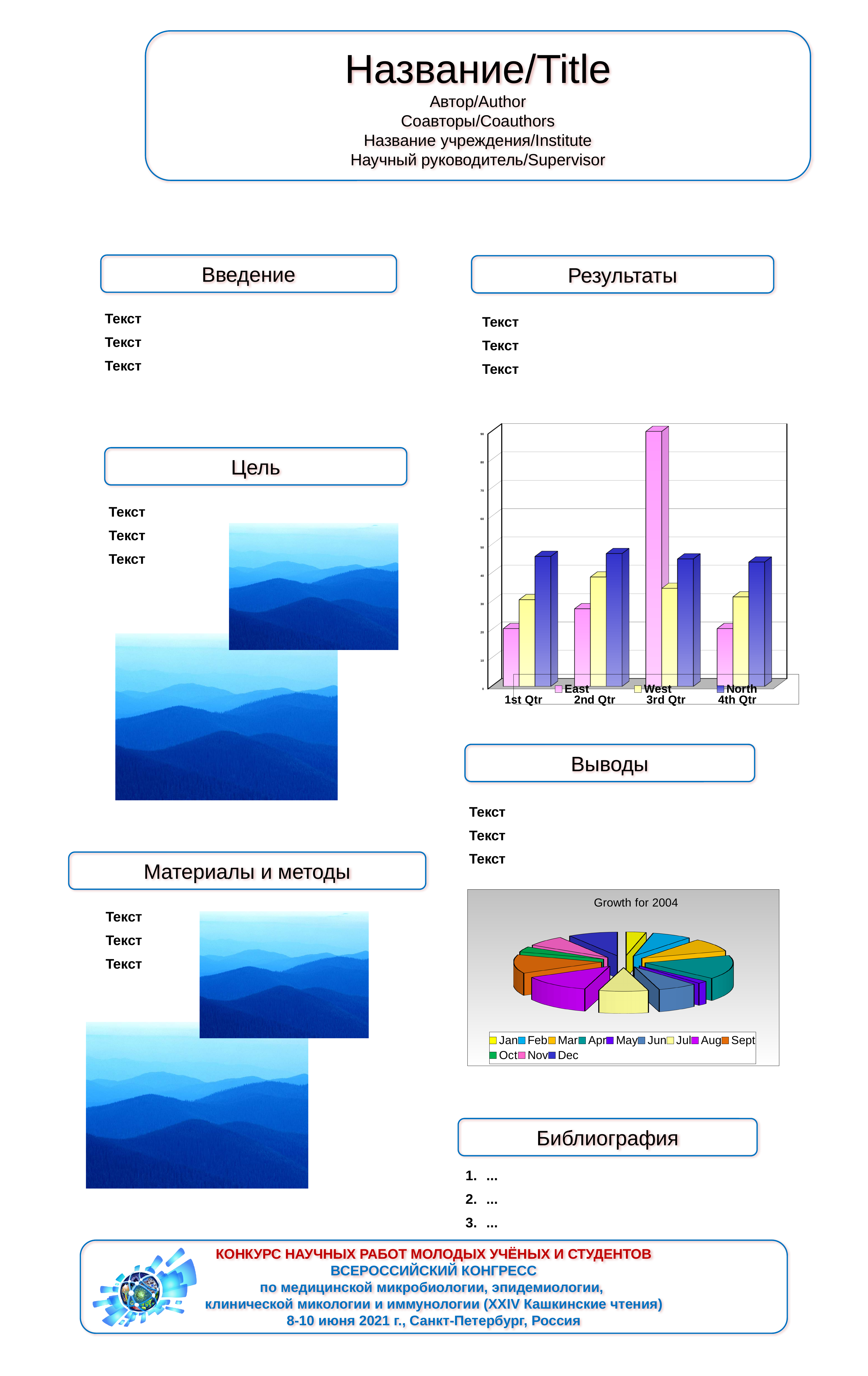
What kind of chart is the chart in the Результаты section (the upper chart on the right)? bar chart In the bar chart in the Результаты section, is the North value for 4th Qtr greater or less than 40? greater How many slices does the pie chart titled Growth for 2004 have? 12 In the bar chart in the Результаты section, is the East value for 3rd Qtr greater or less than 80? greater In the bar chart in the Результаты section, is the East value for 1st Qtr greater or less than 30? less In the bar chart in the Результаты section, which quarter has the highest East value? 3rd Qtr How many quarter categories are shown on the x axis of the bar chart in the Результаты section? 4 How many series does the legend of the bar chart in the Результаты section list? 3 In the bar chart in the Результаты section, which is larger for 2nd Qtr, the West value or the North value? North What is the title of the pie chart in the Выводы section (the lower chart on the right)? Growth for 2004 What kind of chart is the chart titled Growth for 2004? pie chart Which legend entry is listed first in the pie chart titled Growth for 2004? Jan